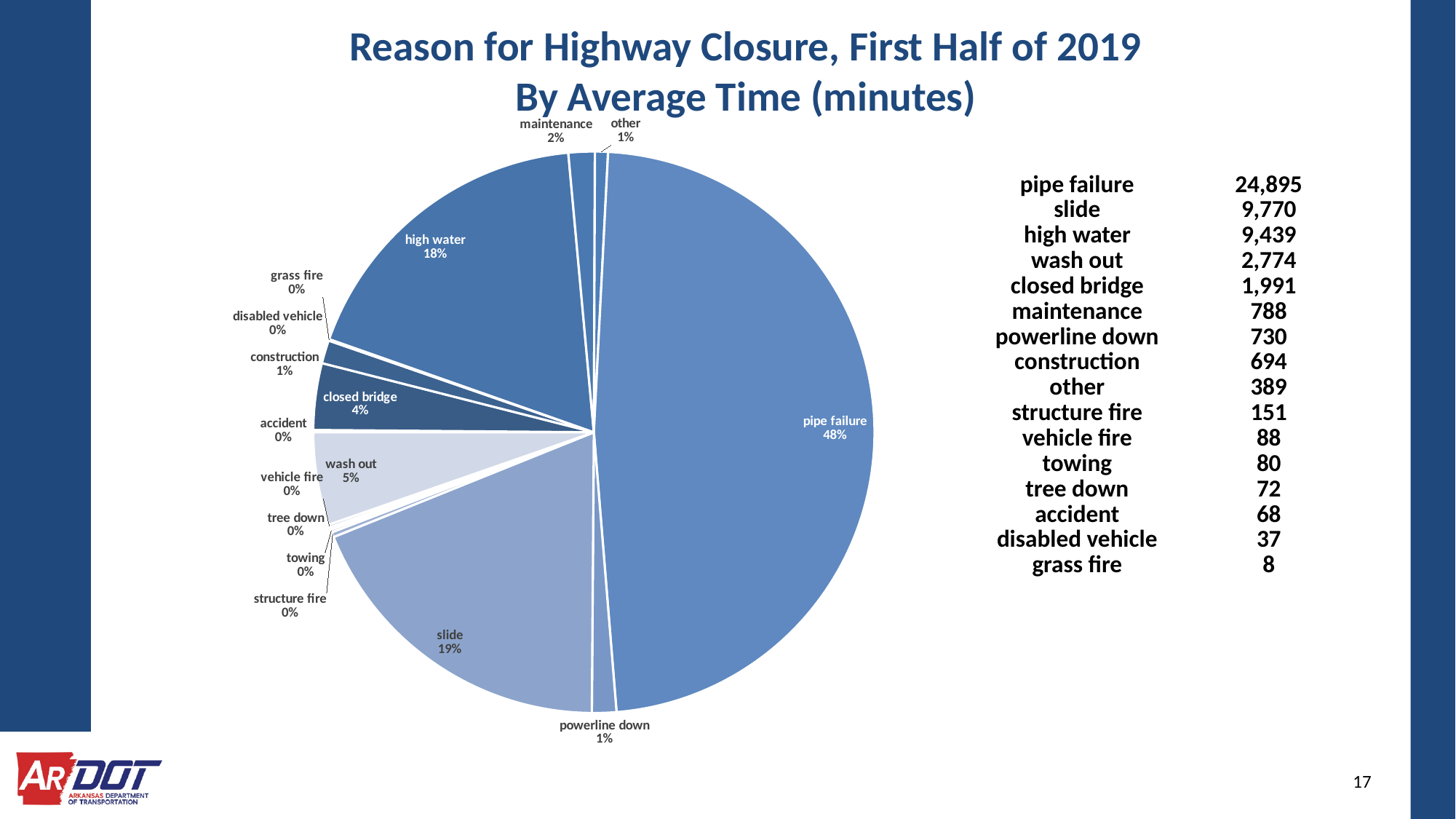
What share of the pie does pipe failure account for? 48% Which reason for highway closure has the smallest value listed on the slide? grass fire Which reason for highway closure has the largest slice of the pie? pipe failure What is the difference in minutes between slide and high water? 331 Which has a larger slice of the pie, slide or high water? slide What percentage of the pie is labelled for slide? 19% How many categories (slices) are shown in the pie chart? 16 What percentage is shown for high water in the pie chart? 18% What is the average time in minutes listed for maintenance? 788 What type of chart is shown on the slide? pie chart What is the average time in minutes listed for closed bridge? 1,991